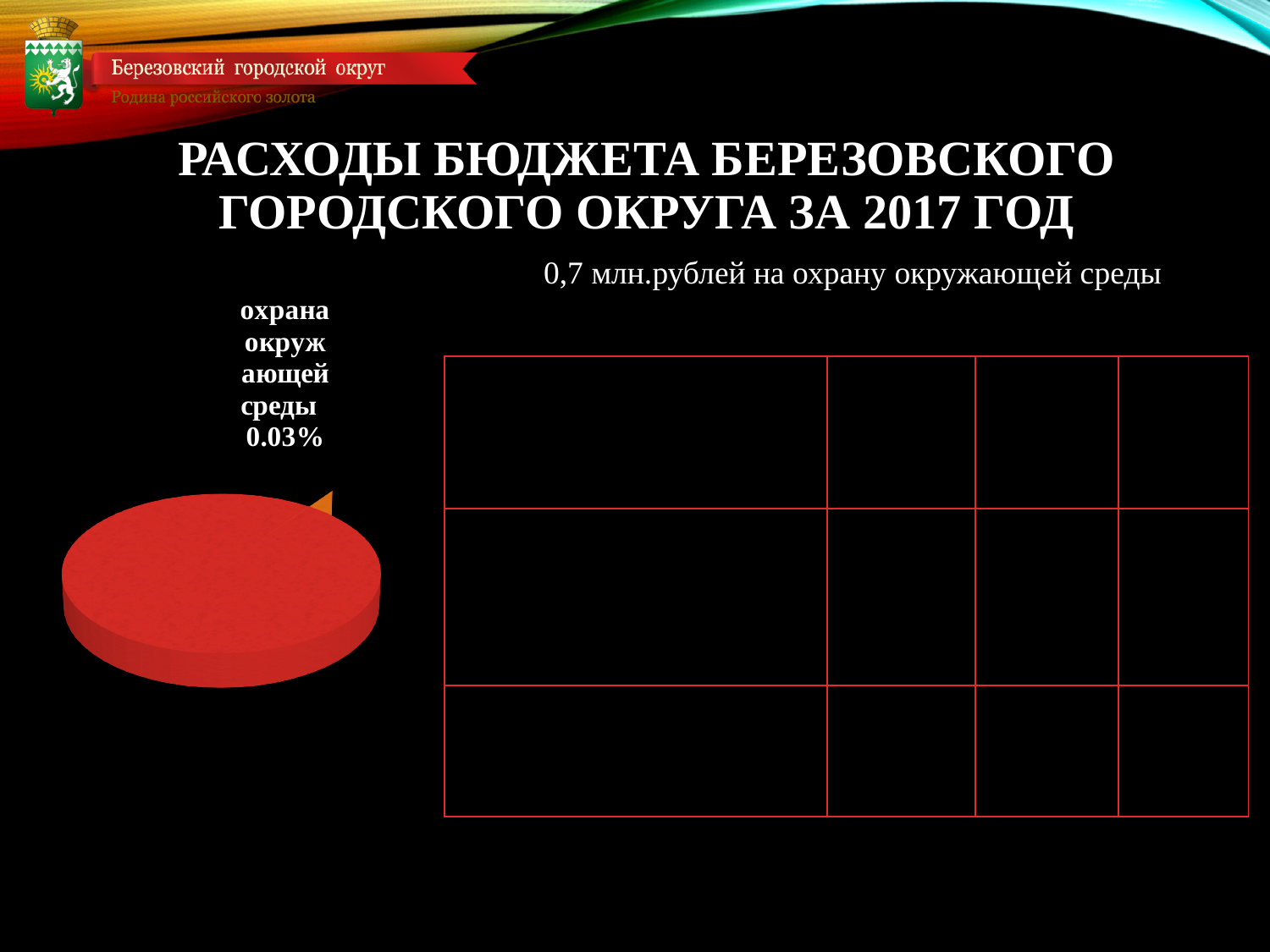
What colour is the slice labelled 'охрана окружающей среды'? orange How many slices are visible in the pie chart? 2 What colour is the large unlabelled slice of the pie? red Which slice is larger, the red slice or the orange slice? the red slice What share of the pie does the slice labelled 'охрана окружающей среды' represent? 0.03% What kind of chart is shown on the slide? pie chart Which slice of the pie is the smallest? охрана окружающей среды What percentage is printed next to the 'охрана окружающей среды' slice? 0.03%